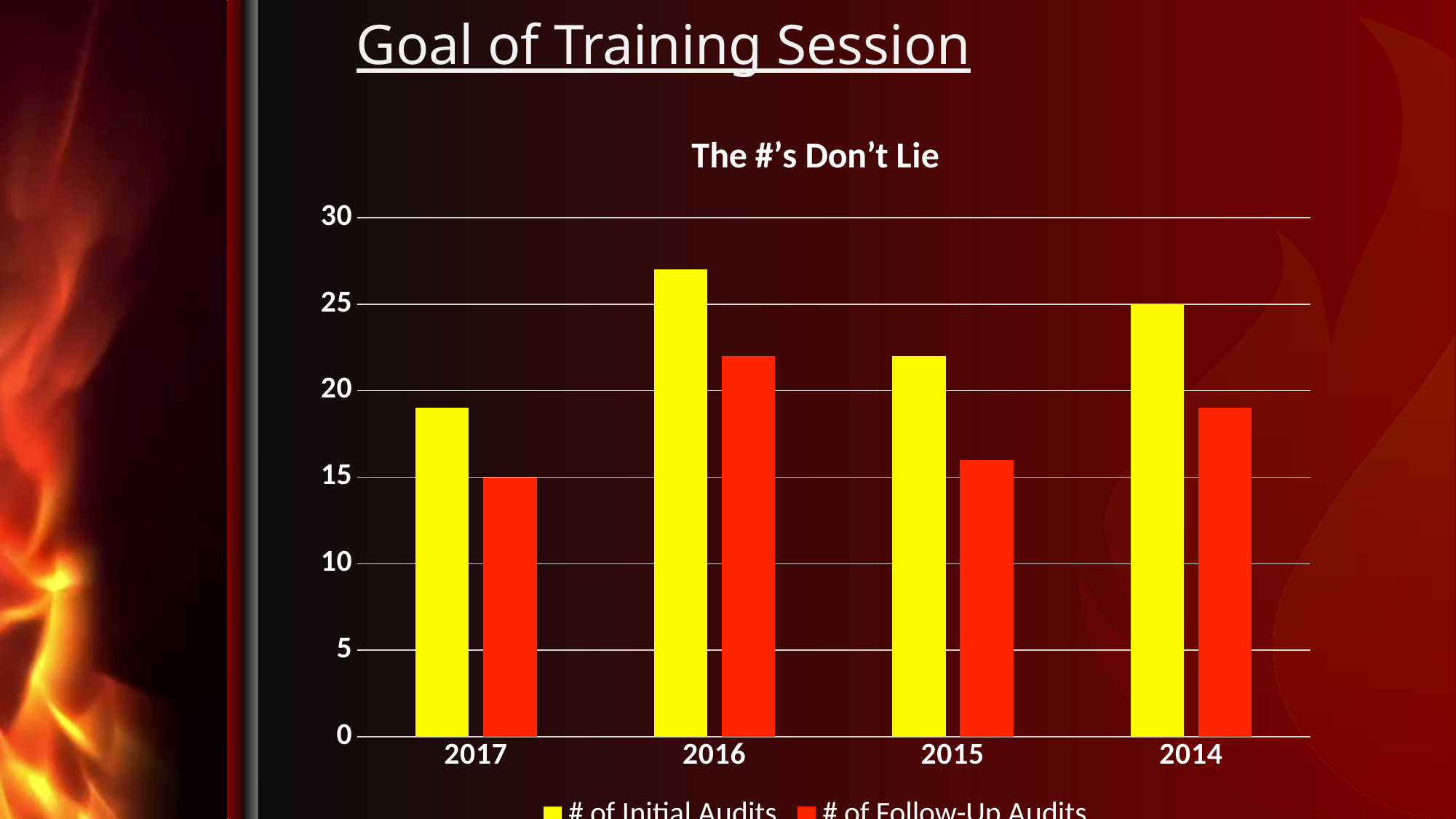
What type of chart is shown on the slide? bar chart Which colour represents # of Follow-Up Audits? red How many years are shown on the x axis? 4 Which year has the lowest # of Follow-Up Audits? 2017 Is the value for # of Follow-Up Audits in 2015 greater or less than 20? less What is the value for # of Follow-Up Audits in 2017? 15 Is the value for # of Initial Audits in 2016 greater or less than 25? greater Which year has the highest # of Initial Audits? 2016 In 2015, which is larger: # of Initial Audits or # of Follow-Up Audits? # of Initial Audits What is the title of the chart? The #'s Don't Lie What is the value for # of Initial Audits in 2014? 25 How many series does the legend list? 2